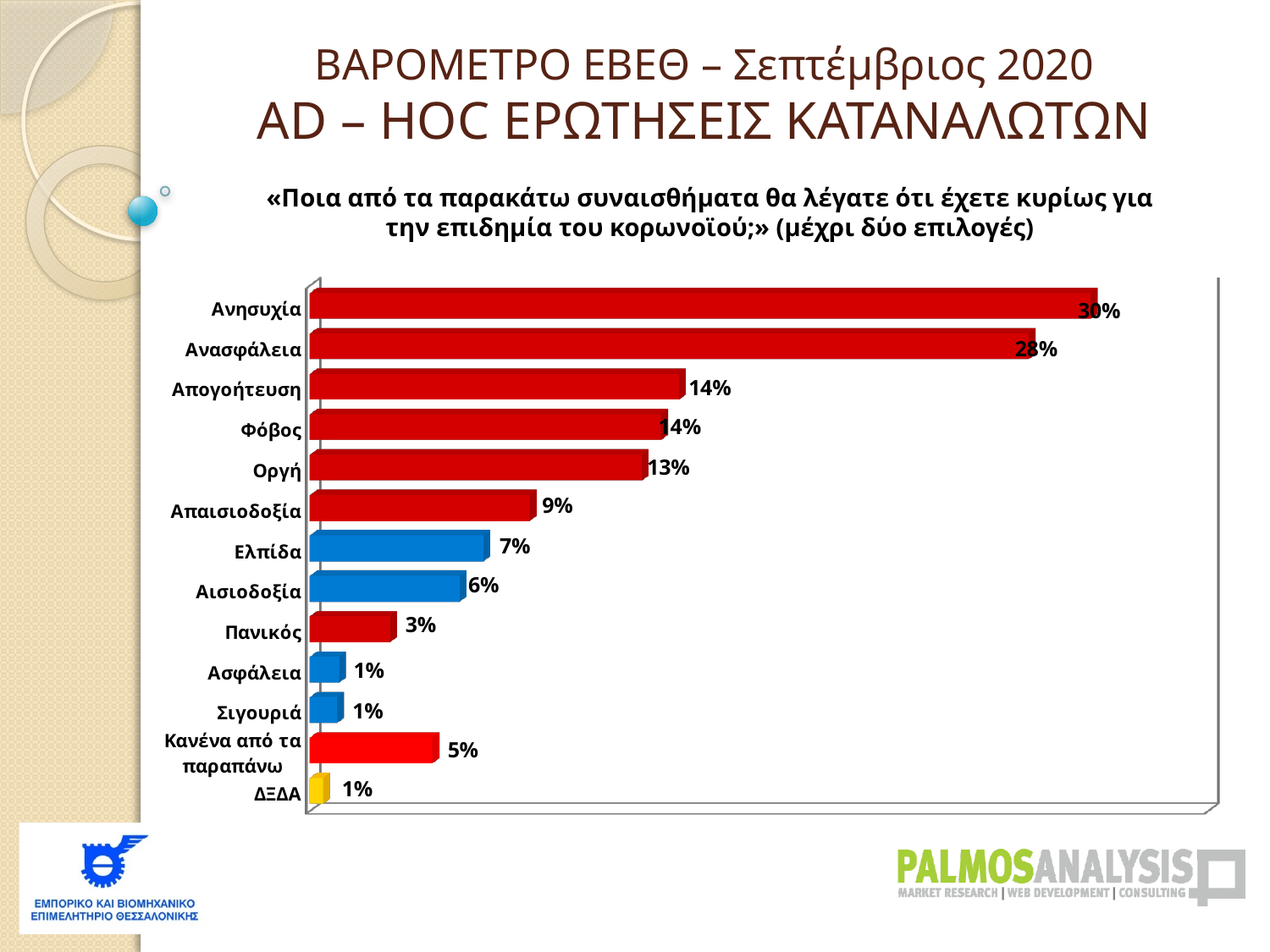
Which has a higher value, Ελπίδα or Αισιοδοξία? Ελπίδα How many categories are shown in the chart? 13 What percentage of respondents chose Ανησυχία? 30% What colour is the bar for ΔΞΔΑ? Yellow What percentage is shown for Οργή? 13% Which has a higher value, Απαισιοδοξία or Κανένα από τα παραπάνω? Απαισιοδοξία What is the difference in percentage points between Ανησυχία and Ανασφάλεια? 2 percentage points What is the value shown for Ανασφάλεια? 28% What percentage is shown for Πανικός? 3% What is the value for Κανένα από τα παραπάνω? 5% What kind of chart is shown on the slide? Bar chart Which category has the highest value in the chart? Ανησυχία